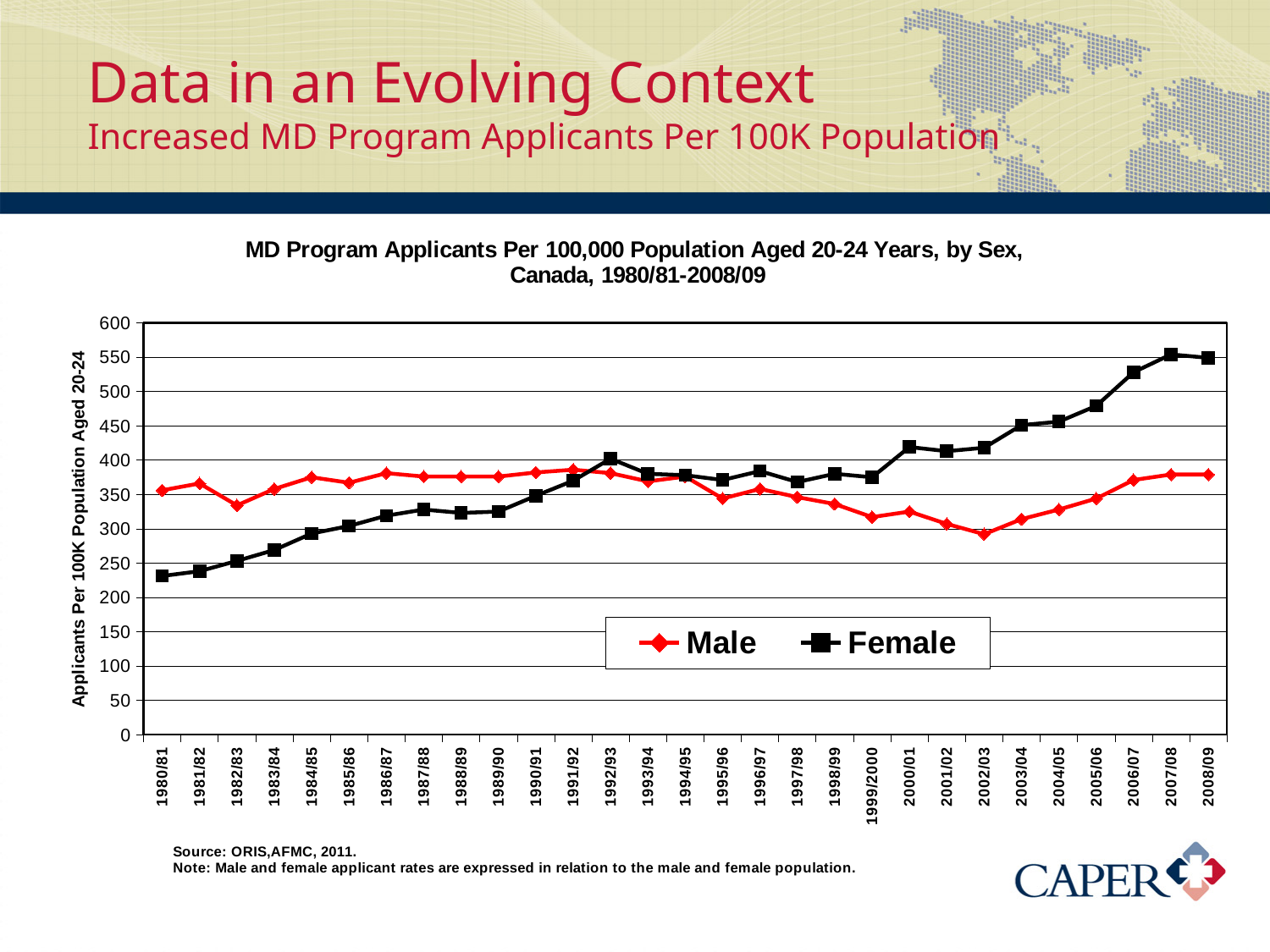
In 1980/81, which series has the larger value, Male or Female? Male In 2008/09, which series has the larger value, Male or Female? Female How many academic years are plotted along the x axis? 29 How many series does the legend list? 2 Which series is drawn in red? Male What kind of chart is shown on the slide? line chart What are the two series shown in the legend? Male and Female Is the Female value for 2000/01 greater or less than 400? greater Is the Female value for 2007/08 greater or less than 500? greater Is the Female value for 1980/81 greater or less than 250? less In which year is the Female value lowest? 1980/81